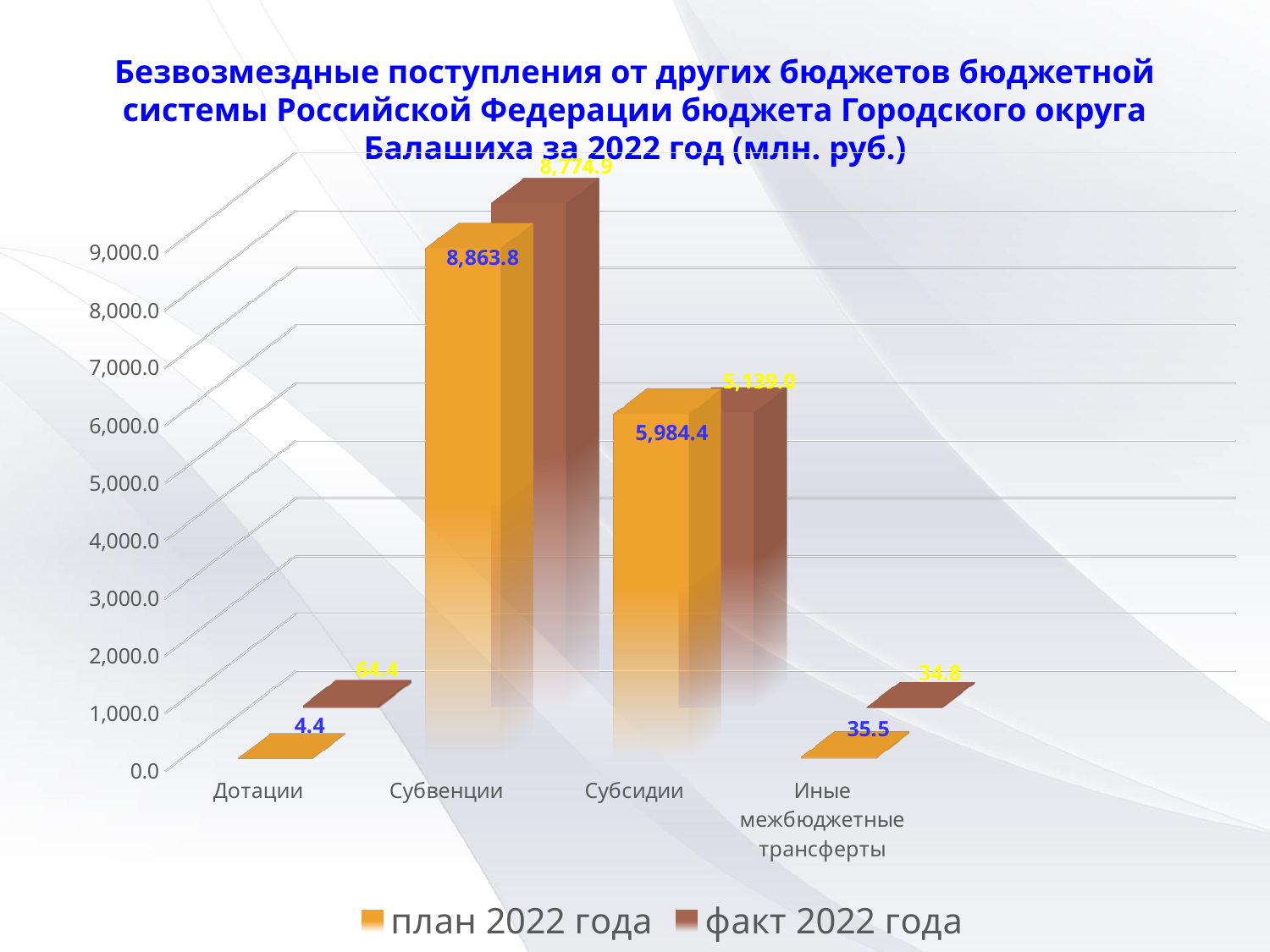
For Дотации, which is larger: план 2022 года or факт 2022 года? факт 2022 года Which category has the lowest план 2022 года value? Дотации Which category has the highest план 2022 года value? Субвенции What is the difference between the план 2022 года and факт 2022 года values for Субвенции? 88.9 Is the факт 2022 года value for Субсидии greater or less than 6,000.0? less What is the факт 2022 года value for Субвенции? 8,774.9 What is the план 2022 года value for Субсидии? 5,984.4 How many categories are shown on the x axis? 4 What is the план 2022 года value for Иные межбюджетные трансферты? 35.5 What is the план 2022 года value for Субвенции? 8,863.8 What is the факт 2022 года value for Дотации? 64.4 How many series does the legend list? 2